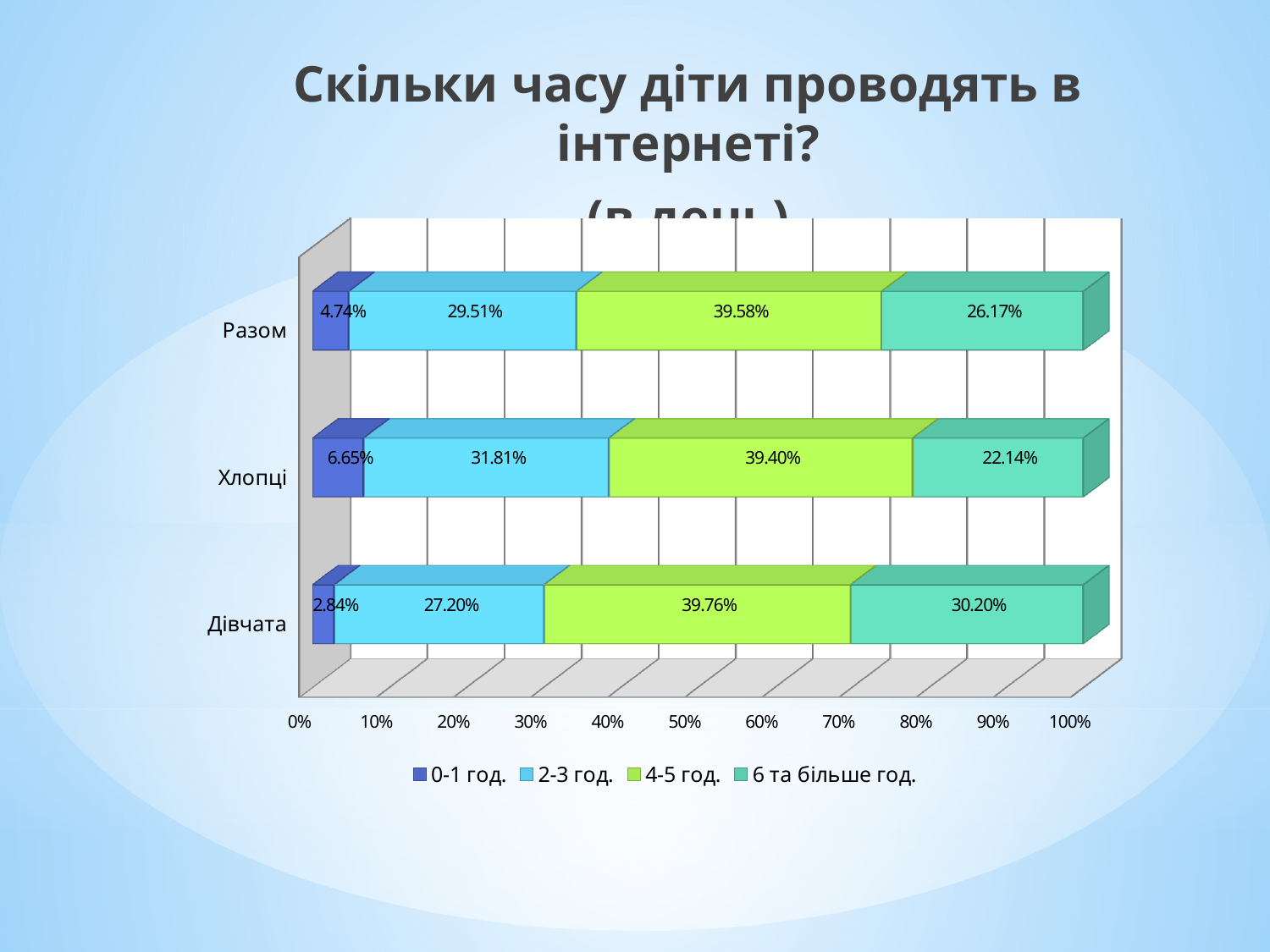
Which series is shown in light green in the legend? 4-5 год. Which is larger: the "2-3 год." value for "Разом" or for "Дівчата"? Разом What type of chart is shown on the slide? Stacked bar chart What is the value for "6 та більше год." in the "Дівчата" category? 30.20% How many series does the legend list? 4 How many categories are shown on the vertical axis? 3 Which category has the lowest value for "6 та більше год."? Хлопці What is the difference between the "0-1 год." values for "Хлопці" and "Дівчата"? 3.81% Which category has the highest value for "0-1 год."? Хлопці What is the value for "2-3 год." in the "Хлопці" category? 31.81% What is the difference between the "6 та більше год." values for "Дівчата" and "Хлопці"? 8.06% What is the value for "0-1 год." in the "Разом" category? 4.74%